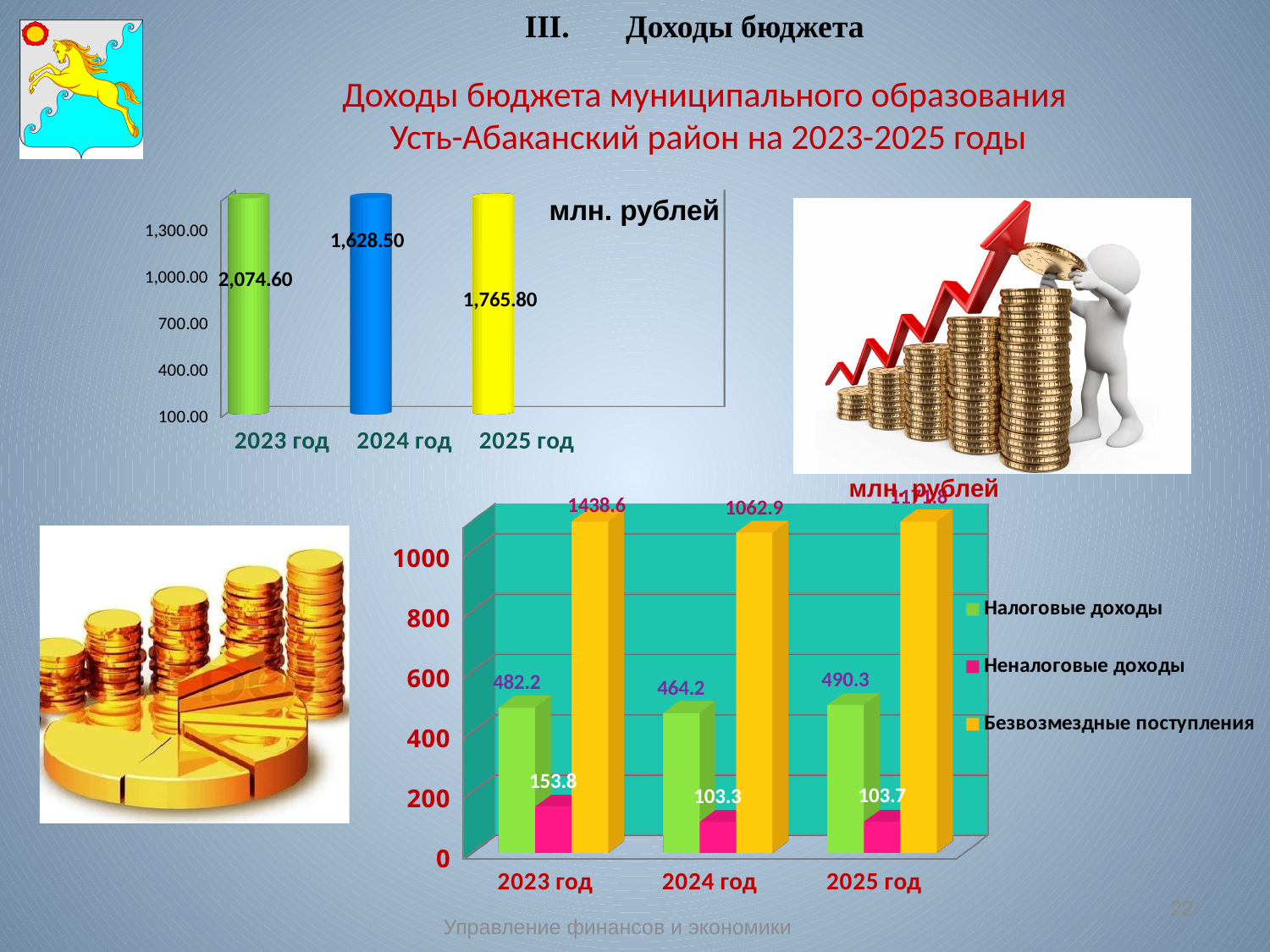
In the top chart, what unit is shown in the chart's label? млн. рублей What kind of chart is the bottom chart? bar chart In the bottom chart, what is the value of Безвозмездные поступления for 2024 год? 1062.9 In the top chart, what is the difference between the values for 2023 год and 2024 год? 446.10 In the bottom chart, what is the value of Налоговые доходы for 2023 год? 482.2 In the bottom chart, what is the difference between Неналоговые доходы for 2023 год and 2024 год? 50.5 In the bottom chart, which year has the highest value of Безвозмездные поступления? 2023 год In the top chart, what is the value for 2024 год? 1,628.50 In the top chart, what is the value for 2023 год? 2,074.60 In the bottom chart, what is the value of Неналоговые доходы for 2024 год? 103.3 In the bottom chart, how many series does the legend list? 3 In the bottom chart, is the value of Налоговые доходы for 2025 год larger than for 2024 год? Yes